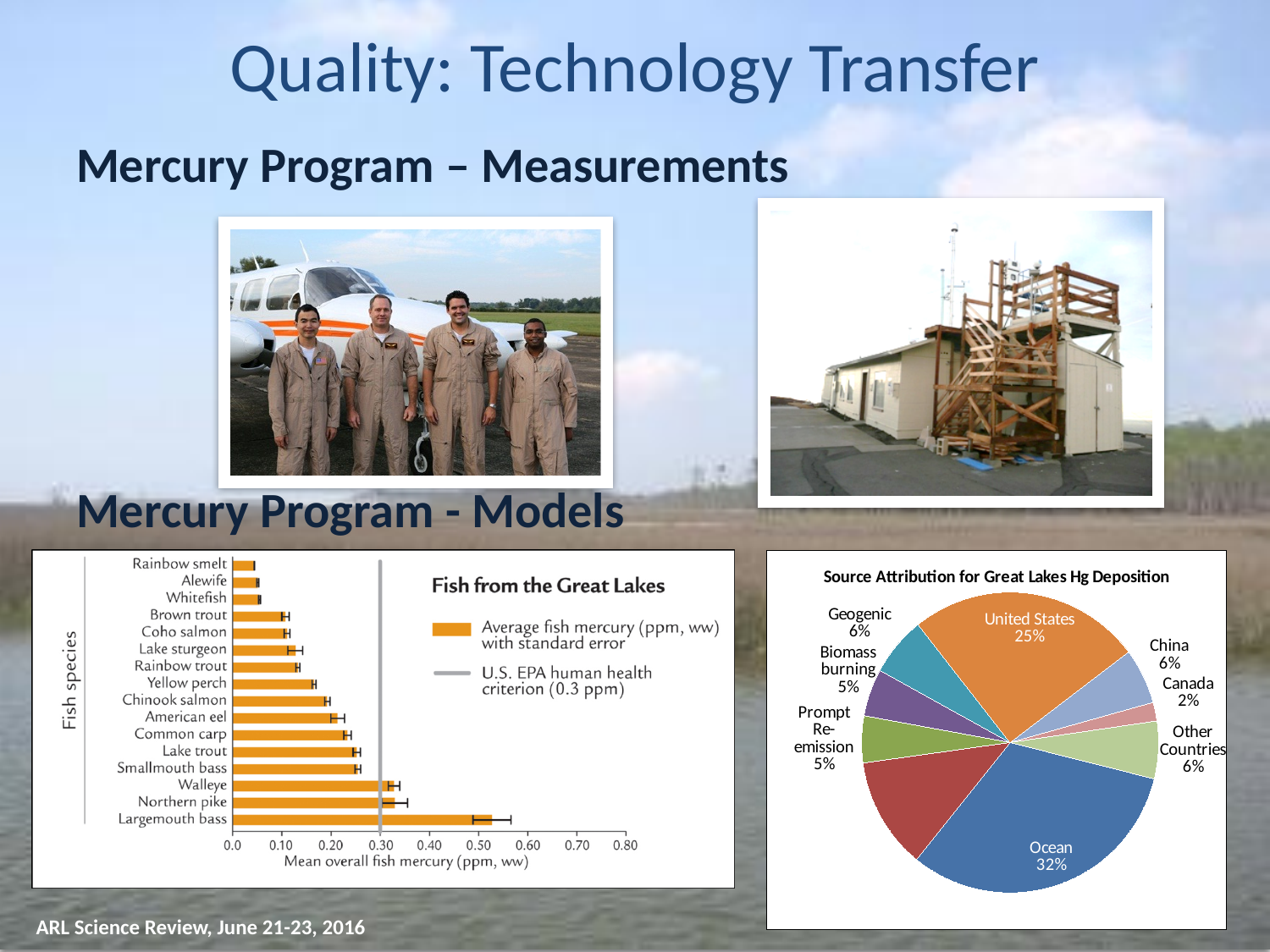
What kind of chart is 'Fish from the Great Lakes'? Bar chart In the 'Source Attribution for Great Lakes Hg Deposition' pie chart, which labeled source has the smallest share? Canada What kind of chart is 'Source Attribution for Great Lakes Hg Deposition'? Pie chart In the 'Fish from the Great Lakes' chart, how many fish species are listed? 16 In the 'Source Attribution for Great Lakes Hg Deposition' pie chart, which has the larger share, China or Canada? China In the 'Source Attribution for Great Lakes Hg Deposition' pie chart, how many percentage points larger is the Ocean share than the United States share? 7% In the 'Source Attribution for Great Lakes Hg Deposition' pie chart, what share is attributed to Canada? 2% In the 'Fish from the Great Lakes' chart, which fish species has the highest mean overall fish mercury? Largemouth bass In the 'Source Attribution for Great Lakes Hg Deposition' pie chart, what share is attributed to the United States? 25% In the 'Source Attribution for Great Lakes Hg Deposition' pie chart, what share is attributed to Ocean? 32% In the 'Source Attribution for Great Lakes Hg Deposition' pie chart, which labeled source has the largest share? Ocean In the 'Fish from the Great Lakes' chart, is the mean overall fish mercury for Largemouth bass greater or less than 0.40 ppm? greater